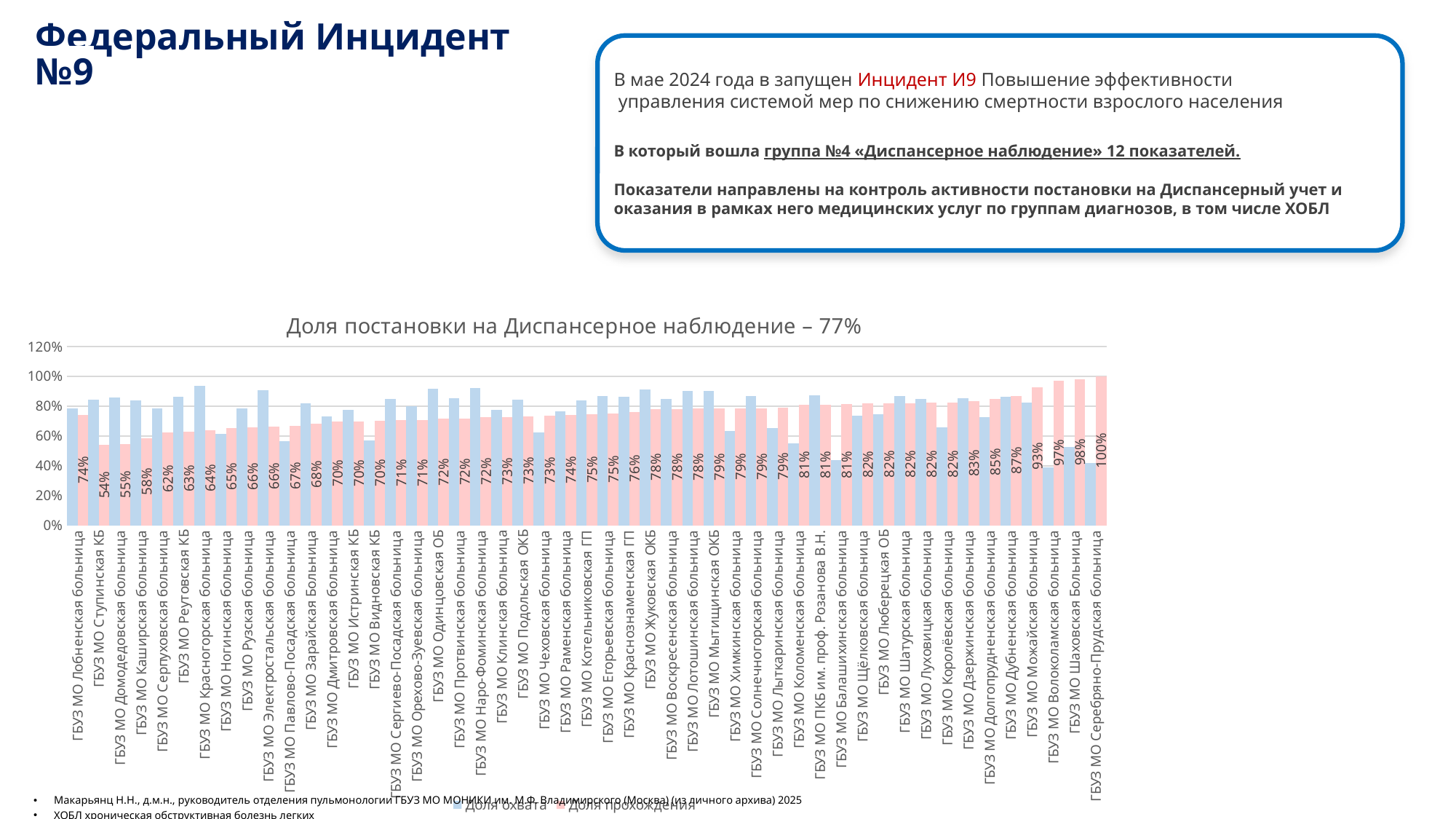
What is the value of Доля прохождения for ГБУЗ МО Можайская больница? 93% Which hospital has the lowest Доля прохождения? ГБУЗ МО Ступинская КБ Which hospital has the highest Доля прохождения? ГБУЗ МО Серебряно-Прудская больница Is the Доля охвата value for ГБУЗ МО Видновская КБ greater or less than 60%? less What is the value of Доля прохождения for ГБУЗ МО Лобненская больница? 74% What is the difference in Доля прохождения between ГБУЗ МО Шаховская больница and ГБУЗ МО Каширская больница? 40% What is the title of the chart? Доля постановки на Диспансерное наблюдение – 77% What is the value of Доля прохождения for ГБУЗ МО Ступинская КБ? 54% Do the Доля прохождения values generally rise or fall from left to right after the first bar? rise Which has a higher Доля прохождения: ГБУЗ МО Дубненская больница or ГБУЗ МО Зарайская больница? ГБУЗ МО Дубненская больница How many series does the chart legend list? 2 What type of chart is shown on the slide? bar chart